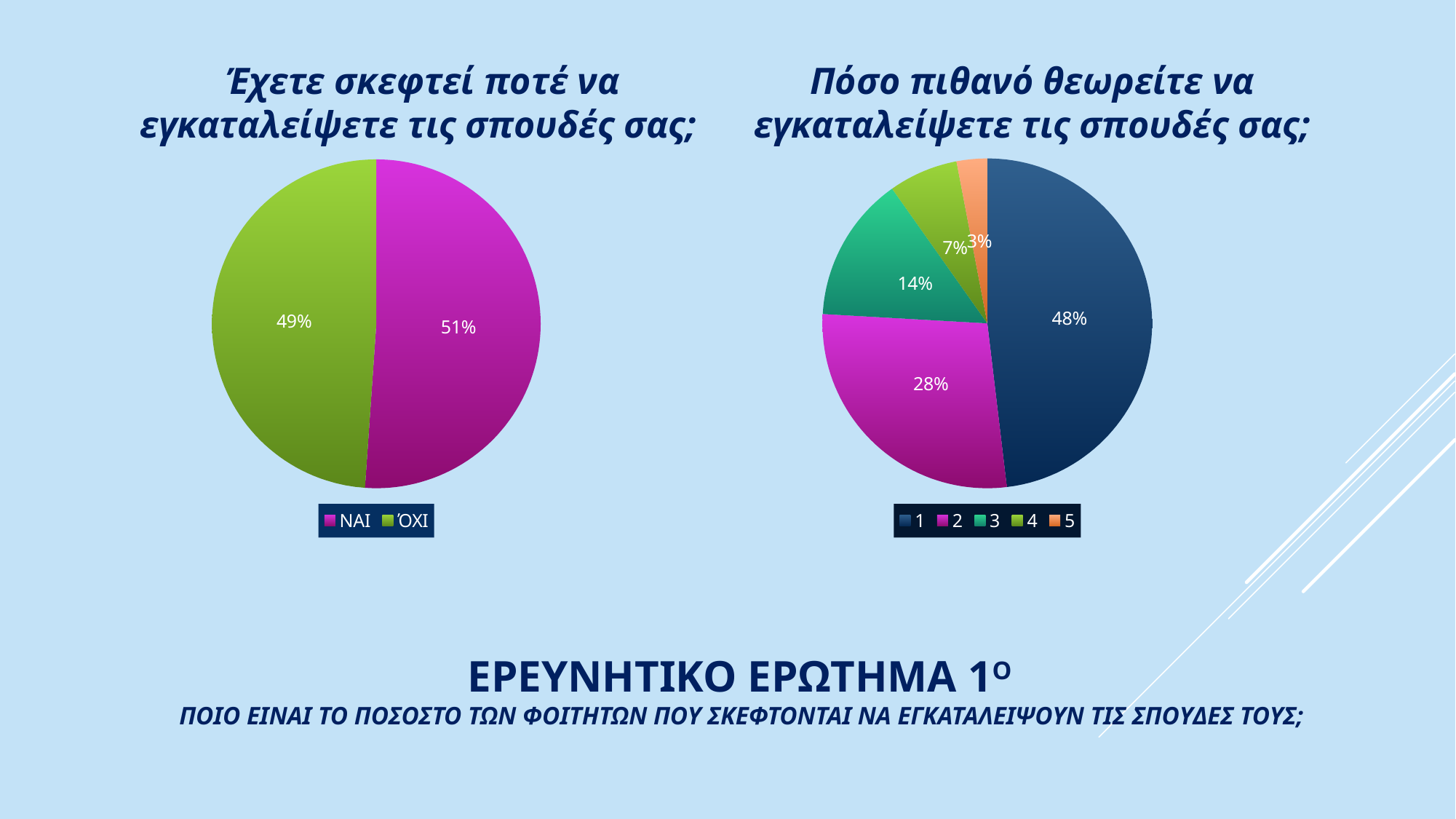
In the left pie chart, which slice is larger, ΝΑΙ or ΌΧΙ? ΝΑΙ How many categories does the legend of the left pie chart list? 2 In the left pie chart ("Έχετε σκεφτεί ποτέ να εγκαταλείψετε τις σπουδές σας;"), what share is labelled for ΝΑΙ? 51% In the right pie chart, which category has the smallest slice? 5 What type of chart is shown on the right side of the slide? Pie chart In the left pie chart, what is the difference in percentage points between ΝΑΙ and ΌΧΙ? 2 How many categories does the legend of the right pie chart list? 5 In the right pie chart ("Πόσο πιθανό θεωρείτε να εγκαταλείψετε τις σπουδές σας;"), what share is labelled for category 1? 48% In the left pie chart, what share is labelled for ΌΧΙ? 49% In the right pie chart, what is the difference in percentage points between category 1 and category 2? 20 In the right pie chart, which category has the largest slice? 1